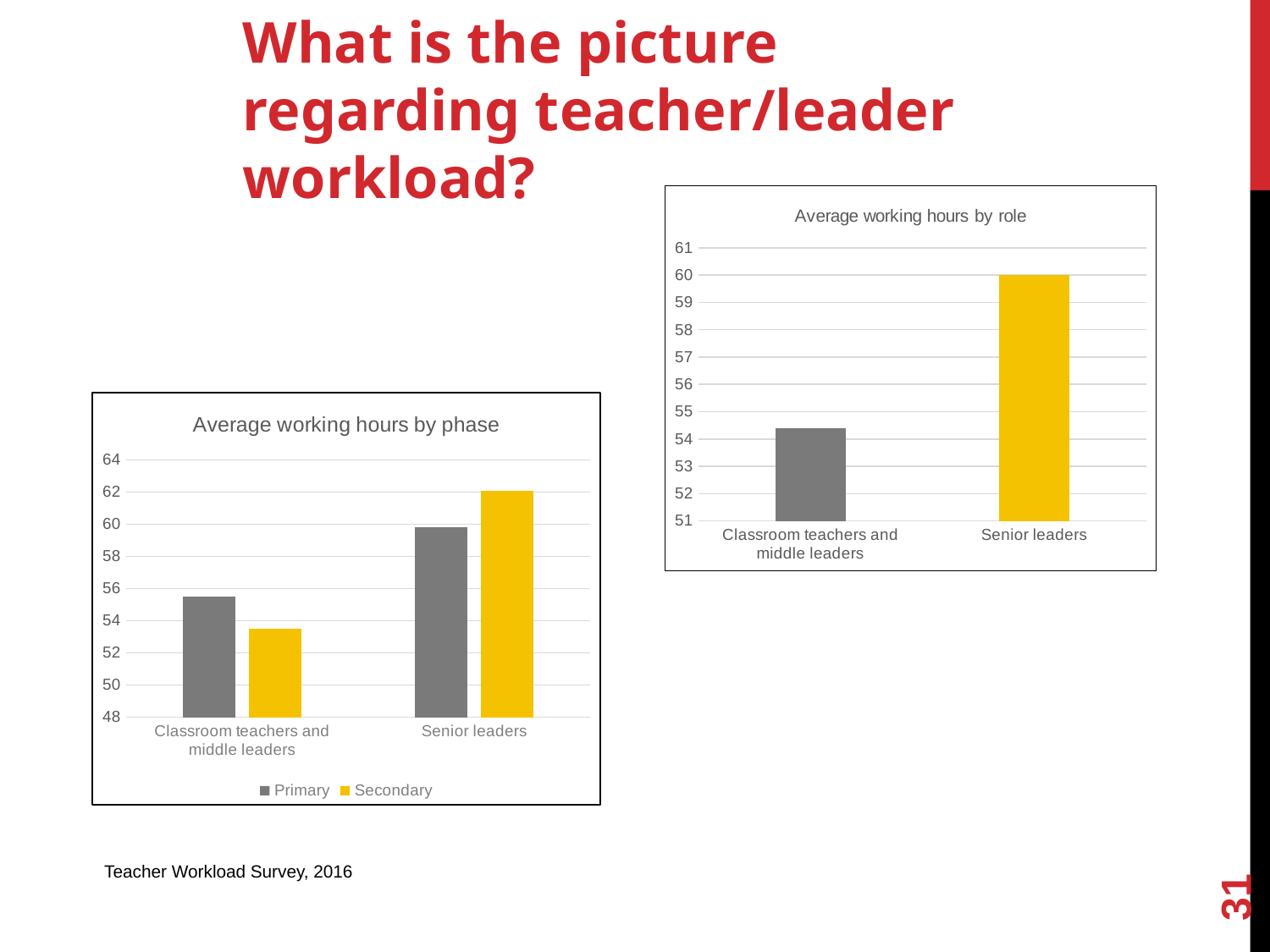
In the chart titled 'Average working hours by phase', what kind of chart is shown? Bar chart In the chart titled 'Average working hours by role', is the value for Classroom teachers and middle leaders greater or less than 55? less In the chart titled 'Average working hours by phase', is the Secondary value for Senior leaders greater or less than 60? greater In the chart titled 'Average working hours by phase', which bar is the tallest? Secondary, Senior leaders In the chart titled 'Average working hours by phase', how many categories are shown on the x axis? 2 In the chart titled 'Average working hours by phase', is the Primary value for Classroom teachers and middle leaders greater or less than 54? greater In the chart titled 'Average working hours by phase', for Senior leaders, is the Primary or Secondary value larger? Secondary What is the title of the chart on the right of the slide? Average working hours by role In the chart titled 'Average working hours by phase', for Classroom teachers and middle leaders, is the Primary or Secondary value larger? Primary In the chart titled 'Average working hours by phase', which bar is the shortest? Secondary, Classroom teachers and middle leaders In the chart titled 'Average working hours by phase', how many series does the legend list? 2 In the chart titled 'Average working hours by role', which category has the highest value? Senior leaders